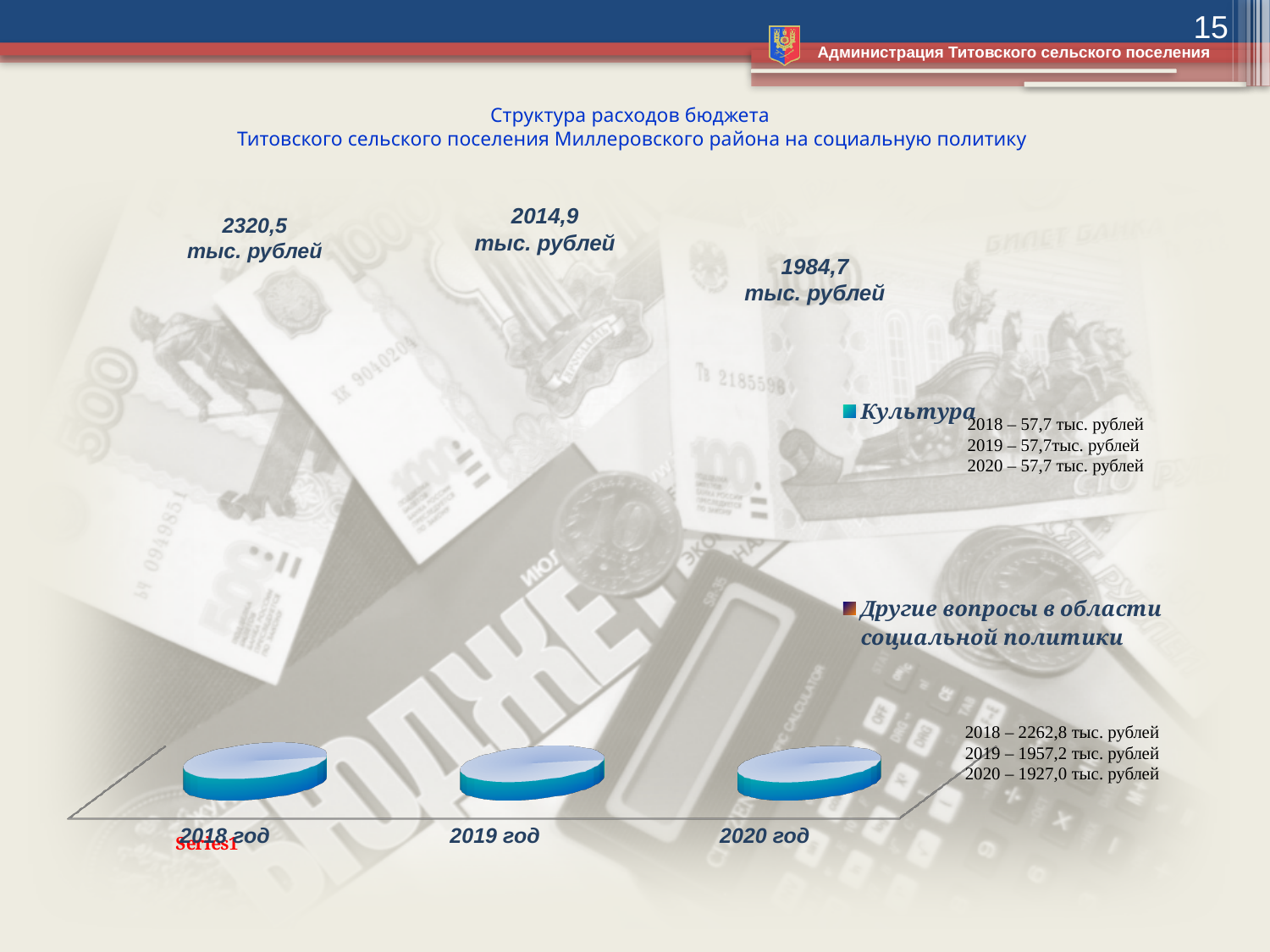
How many series does the chart legend list? 2 What is the difference between the total expenditure for 2018 год and 2020 год? 335,8 тыс. рублей Which is larger, the total expenditure for 2019 год or for 2020 год? 2019 год Which year has the highest total social policy expenditure? 2018 год What is the total social policy expenditure shown for 2018 год? 2320,5 тыс. рублей What is the total social policy expenditure shown for 2020 год? 1984,7 тыс. рублей How many years (categories) are shown on the chart? 3 Which year has the lowest total social policy expenditure? 2020 год What is the expenditure on Культура in 2019 according to the slide? 57,7 тыс. рублей What kind of chart is shown on the slide? Bar chart What is the total social policy expenditure shown for 2019 год? 2014,9 тыс. рублей Do the total expenditure values rise or fall from 2018 год to 2020 год? Fall